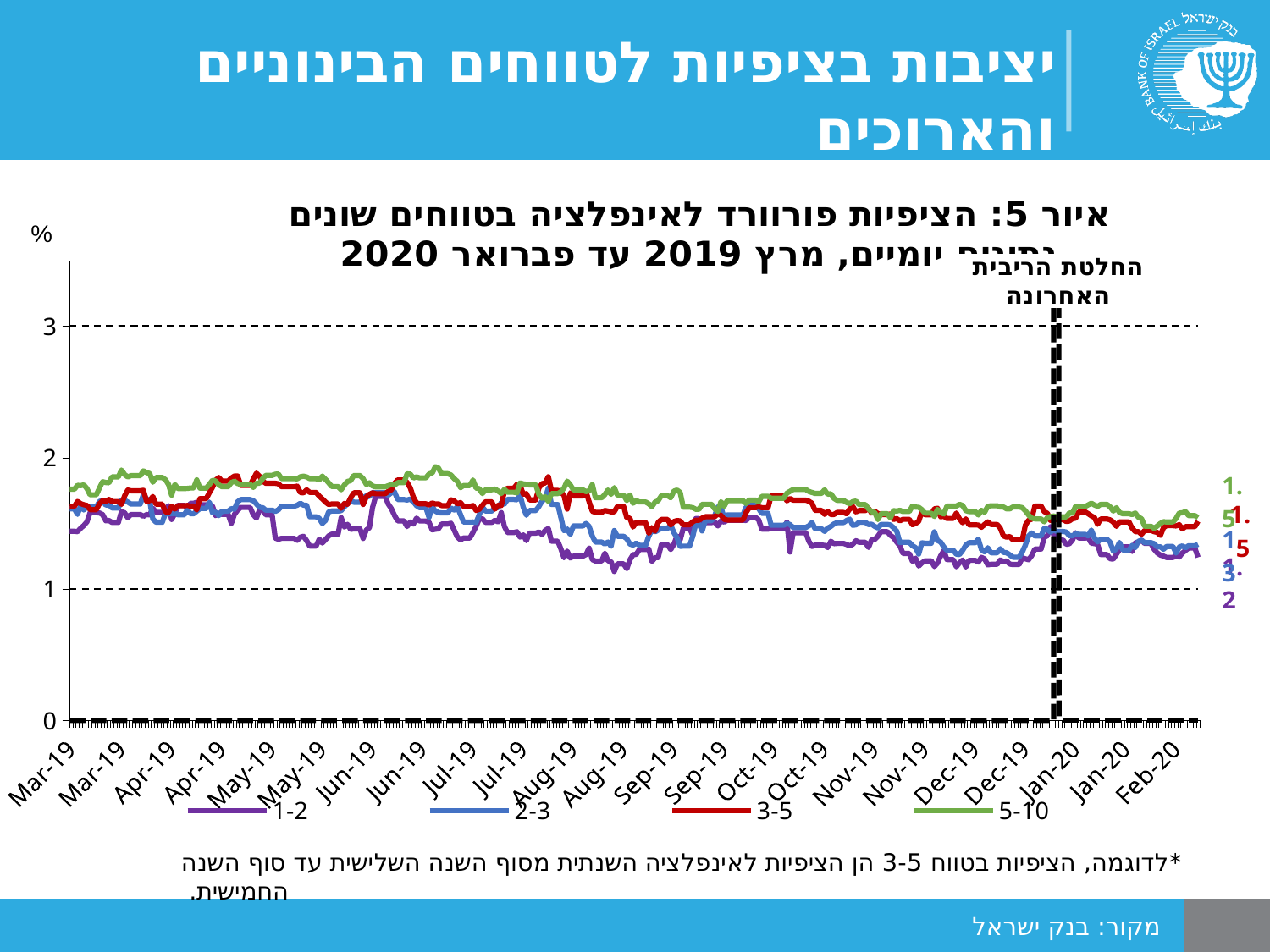
What kind of chart is shown on the slide? line chart How many series does the legend list? 4 Which series is plotted highest across most of the period? 5-10 Is the value of the 3-5 series in Feb-20 greater or less than 2? less Do the values of the 5-10 series generally rise or fall from Mar-19 to Feb-20? fall Is the value of the 5-10 series in Mar-19 greater or less than 2? less In Feb-20, which series has the larger value: 5-10 or 1-2? 5-10 Is the value of the 1-2 series in Dec-19 greater or less than 1? greater Which series is plotted lowest across most of the period? 1-2 What is the highest tick value shown on the y axis? 3 Which colour is used for the 3-5 series? red